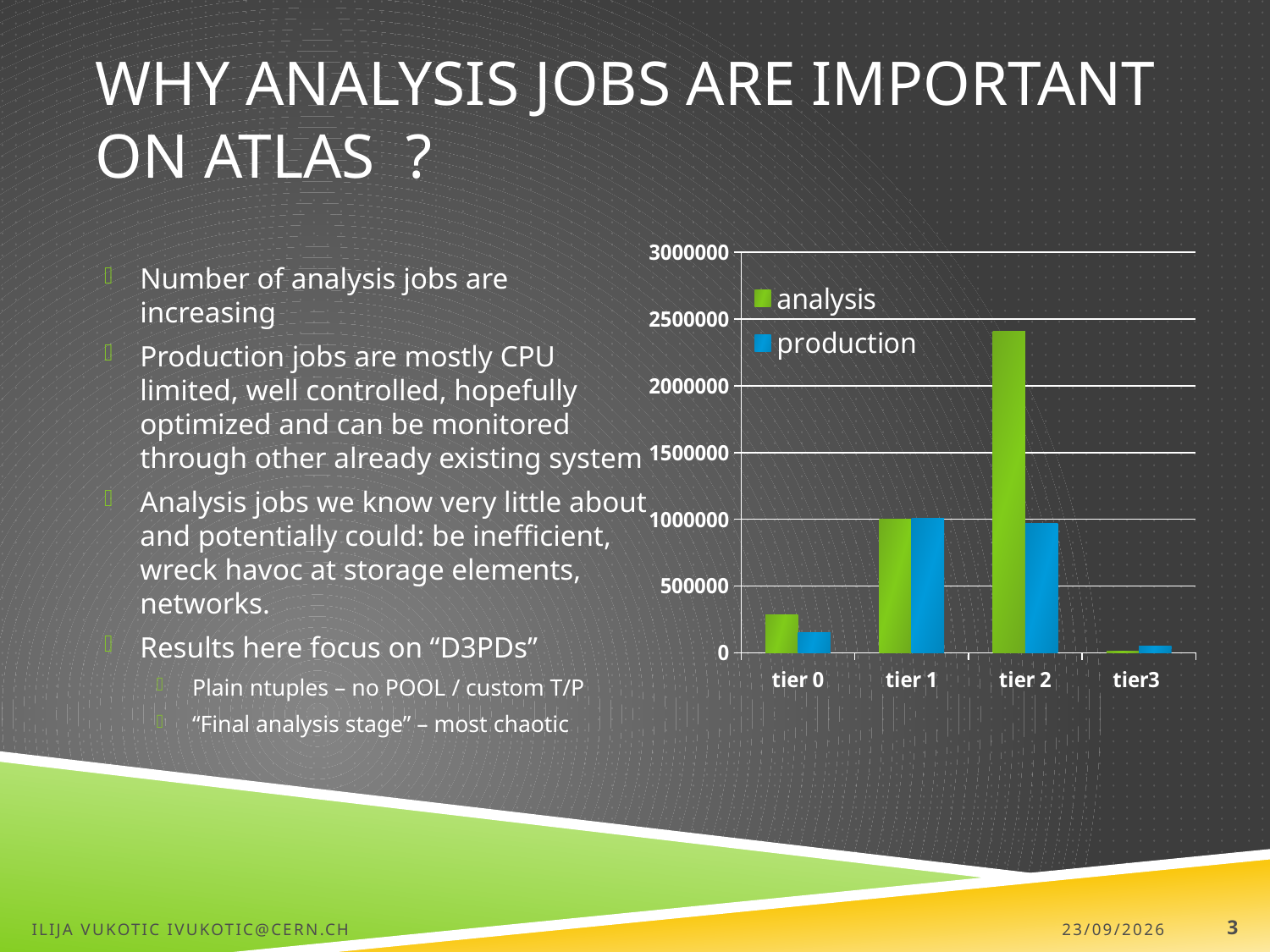
Is the analysis value for tier 0 greater or less than 500000? less How many series does the chart's legend list? 2 For tier 0, which series has the larger value, analysis or production? analysis Which category has the highest value for the analysis series? tier 2 Is the analysis value for tier 2 greater or less than 2000000? greater For tier 2, which series has the larger value, analysis or production? analysis How many categories are shown on the x axis of the chart? 4 Is the production value for tier 2 greater or less than 1500000? less What colour are the bars for the analysis series? green Which category has the lowest value for the analysis series? tier3 What kind of chart is shown on the slide? bar chart